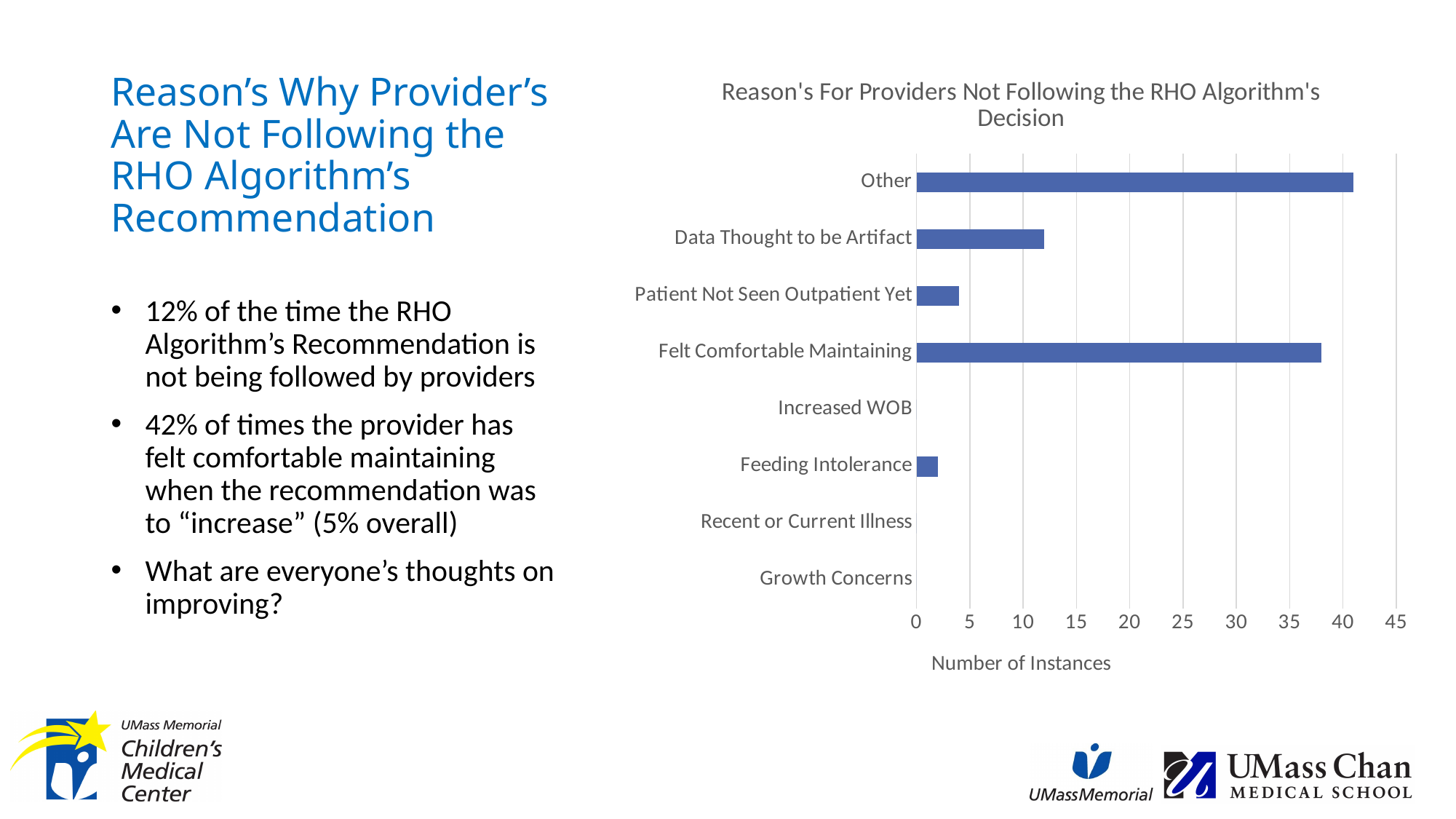
Is the value for Felt Comfortable Maintaining greater or less than 35? greater Is the value for Feeding Intolerance greater or less than 5? less What kind of chart is shown on the slide? bar chart What is the label of the horizontal axis of the chart? Number of Instances Is the value for Other greater or less than 35? greater What is the title of the chart? Reason's For Providers Not Following the RHO Algorithm's Decision Which is larger, the value for Data Thought to be Artifact or the value for Patient Not Seen Outpatient Yet? Data Thought to be Artifact Which is larger, the value for Felt Comfortable Maintaining or the value for Data Thought to be Artifact? Felt Comfortable Maintaining Which category has the highest number of instances? Other How many categories are shown on the chart? 8